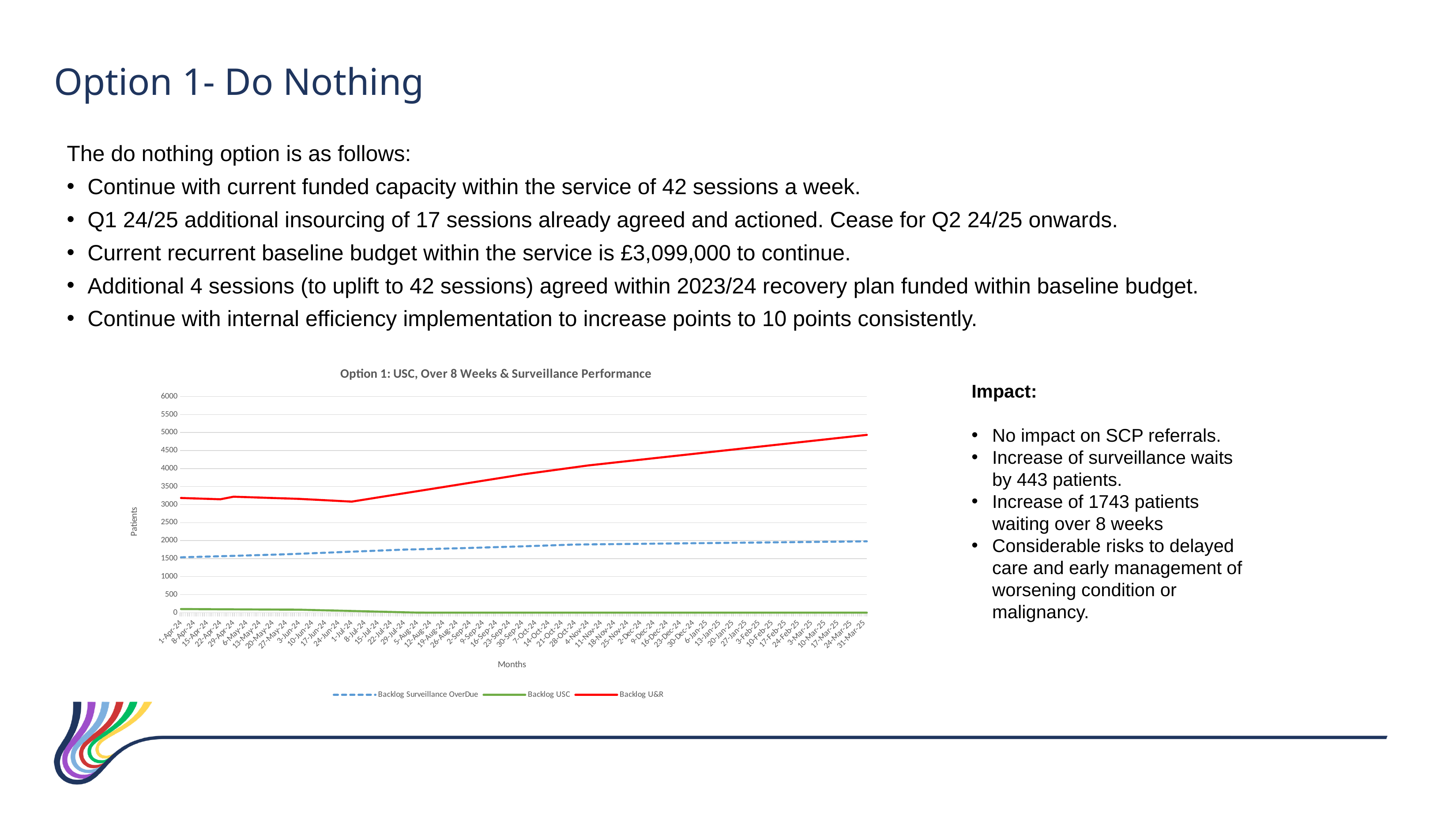
Is the value for Backlog U&R at 1-Apr-24 greater or less than 3500? less What is the title of the chart? Option 1: USC, Over 8 Weeks & Surveillance Performance Does the Backlog Surveillance OverDue series rise or fall overall from 1-Apr-24 to 31-Mar-25? Rise Which series has the highest values across the chart? Backlog U&R Is the value for Backlog Surveillance OverDue at 31-Mar-25 greater or less than 1500? greater What is the label on the chart's vertical axis? Patients Which series has the lowest values across the chart? Backlog USC At 31-Mar-25, which is larger: Backlog U&R or Backlog USC? Backlog U&R Is the value for Backlog U&R at 31-Mar-25 greater or less than 4500? greater Does the Backlog U&R series rise or fall overall from 1-Apr-24 to 31-Mar-25? Rise How many series does the chart legend list? 3 What kind of chart is shown on the slide? Line chart